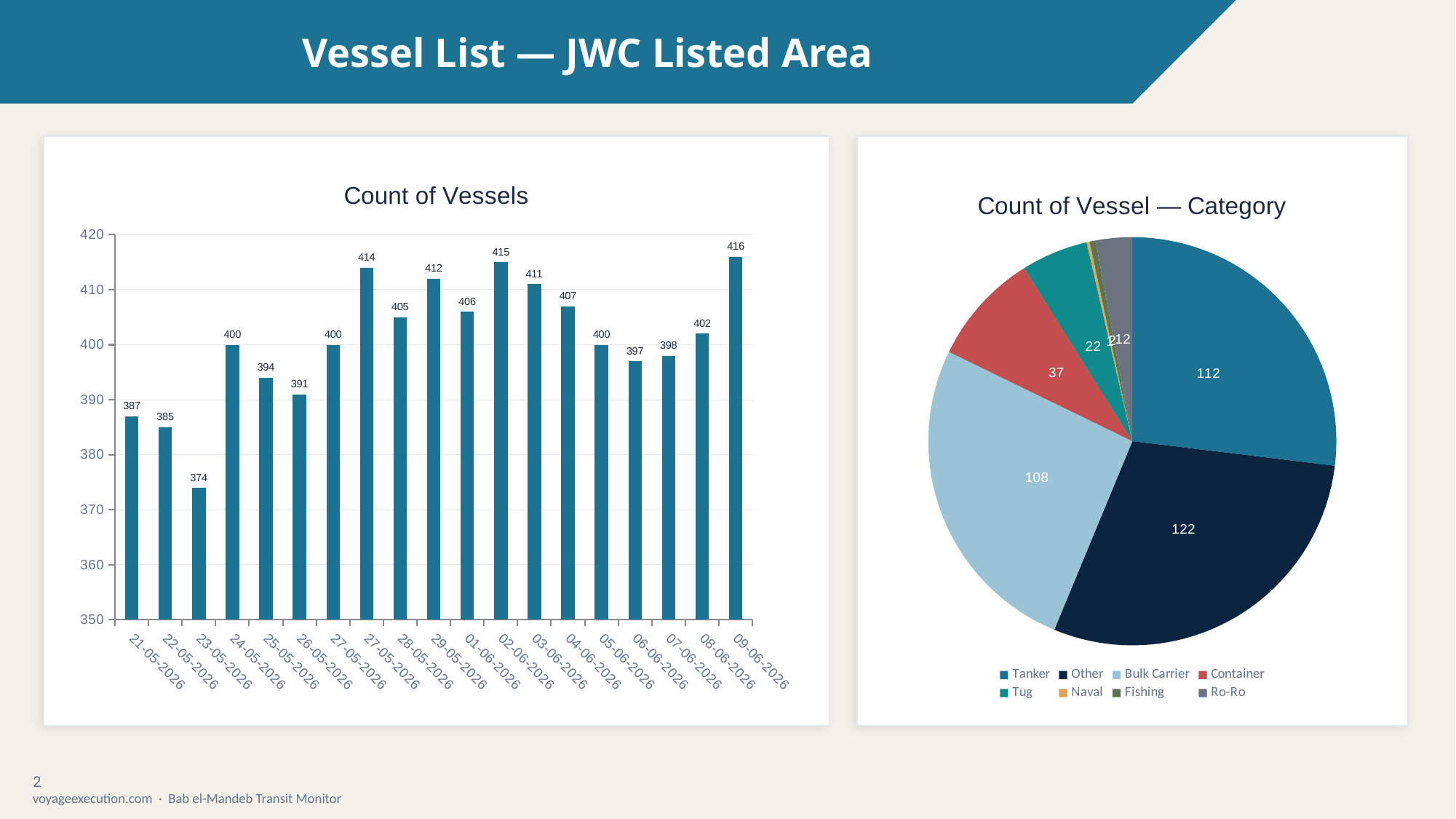
How many bars are plotted in the 'Count of Vessels' chart? 19 In the 'Count of Vessels' bar chart, which date has the lowest count? 23-05-2026 In the 'Count of Vessels' bar chart, which is larger, the value for 02-06-2026 or for 03-06-2026? 02-06-2026 In the 'Count of Vessel — Category' pie chart, which category has the largest slice? Other What kind of chart is the 'Count of Vessels' chart on the left? Bar chart In the 'Count of Vessel — Category' pie chart, what is the value for Other? 122 In the 'Count of Vessels' bar chart, what is the value for 23-05-2026? 374 In the 'Count of Vessel — Category' pie chart, which is larger, Tanker or Bulk Carrier? Tanker How many categories does the legend of the 'Count of Vessel — Category' pie chart list? 8 In the 'Count of Vessels' bar chart, which date has the highest count? 09-06-2026 In the 'Count of Vessels' bar chart, what is the difference between the values for 09-06-2026 and 21-05-2026? 29 In the 'Count of Vessel — Category' pie chart, what is the difference between the values for Other and Container? 85